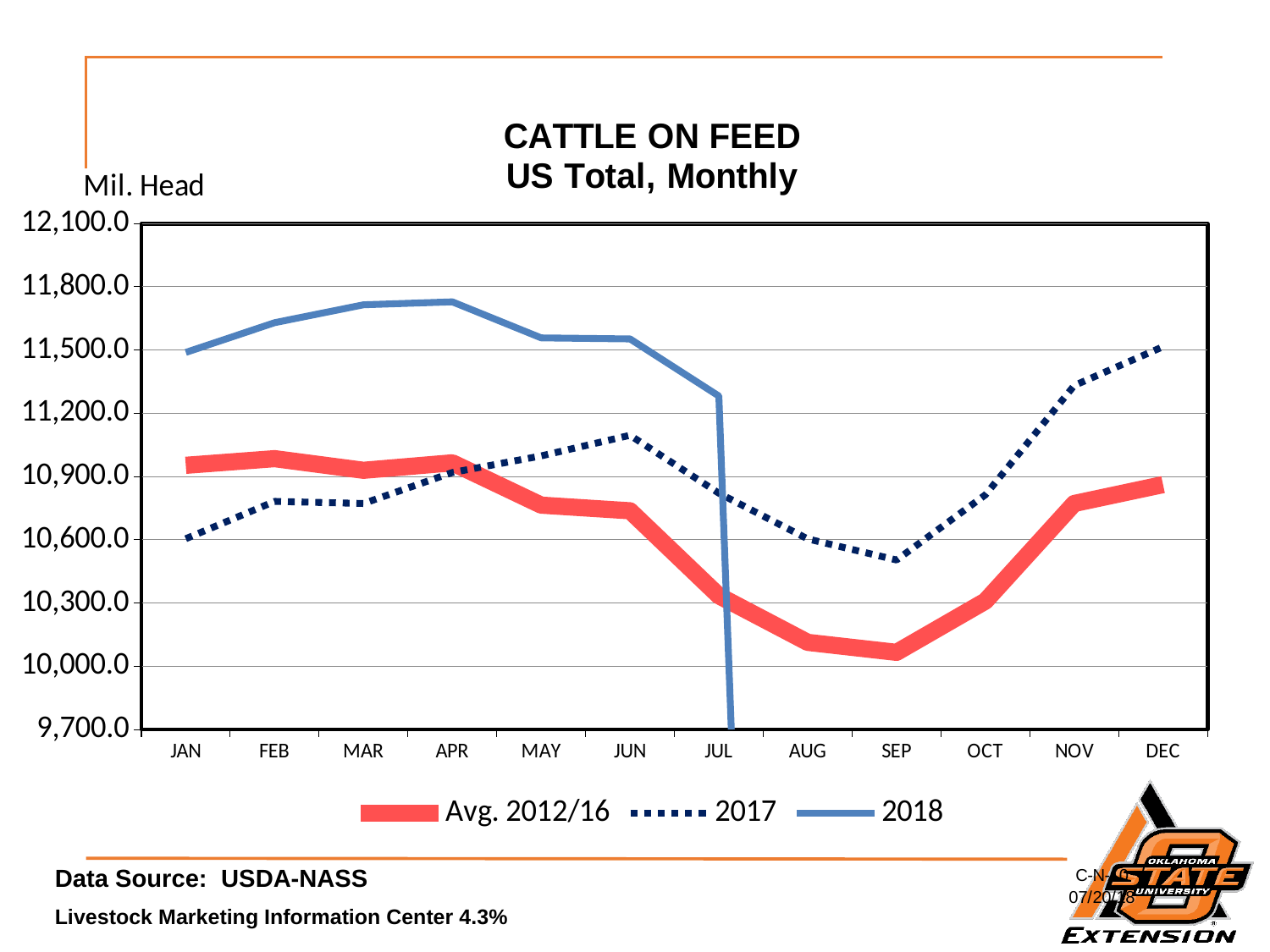
What is the title of the chart? CATTLE ON FEED US Total, Monthly How many months are shown along the x axis? 12 What kind of chart is shown on the slide? Line chart In which month is the 2017 series at its lowest? SEP Is the Avg. 2012/16 value for SEP greater or less than 10,300.0? less How many series does the legend list? 3 Is the 2017 value for JAN greater or less than 10,900.0? less In which month is the 2017 series at its highest? DEC Is the 2018 value for APR greater or less than 11,500.0? greater Does the 2017 series rise or fall from SEP to DEC? Rise In MAR, which series is larger: 2018 or 2017? 2018 What unit label is shown above the y axis? Mil. Head